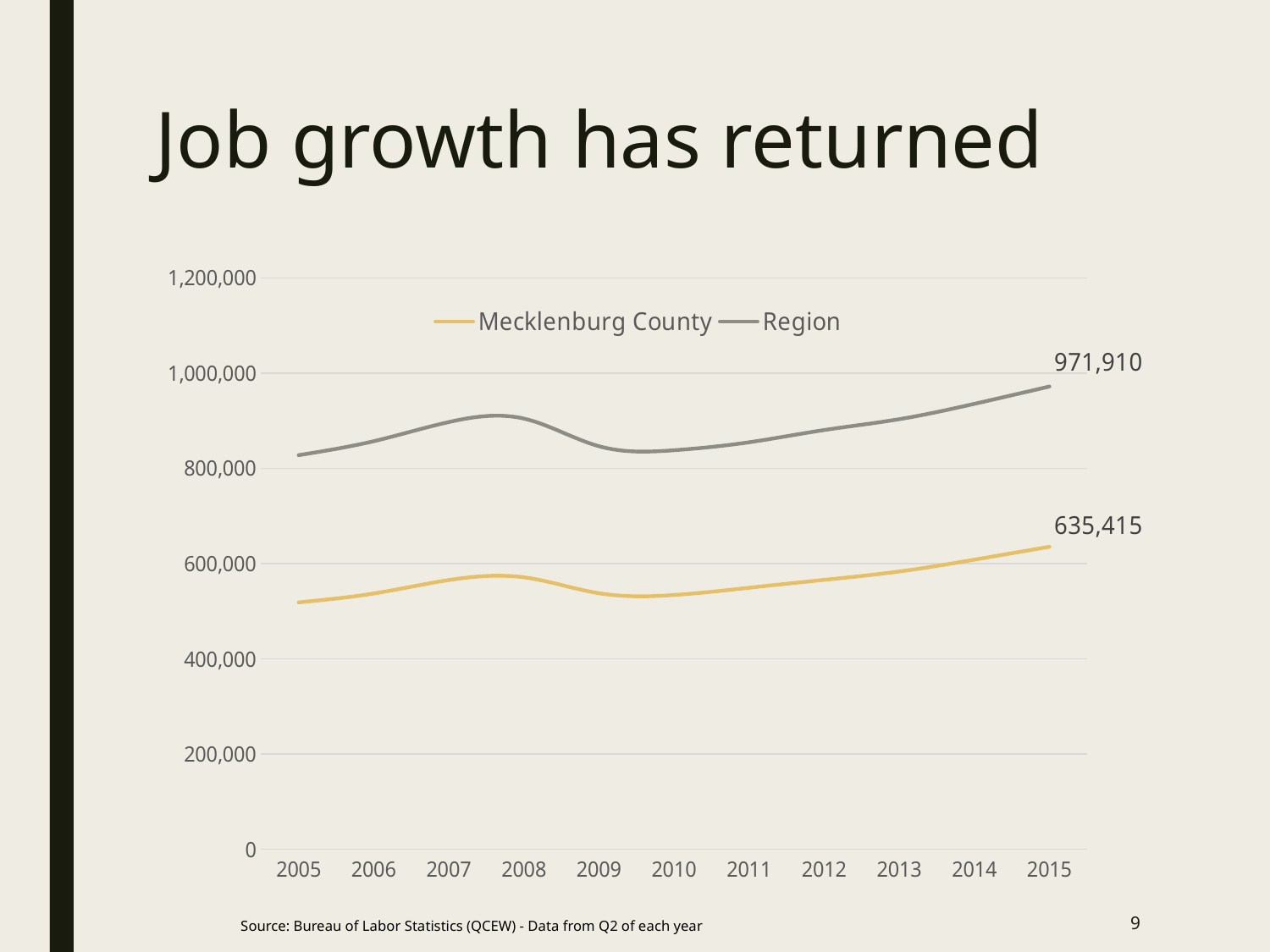
Is the value for Mecklenburg County in 2005 greater or less than 600,000? less What kind of chart is shown on the slide? Line chart Do the Region values rise or fall from 2010 to 2015? Rise Is the value for Region in 2005 greater or less than 800,000? greater What is the value for Mecklenburg County in 2015? 635,415 How many years are shown on the x axis? 11 What is the difference between the Region and Mecklenburg County values in 2015? 336,495 What is the value for Region in 2015? 971,910 What is the title of the slide? Job growth has returned Is the value for Region in 2008 greater or less than 1,000,000? less In 2015, which series has the larger value, Region or Mecklenburg County? Region How many series does the legend list? 2